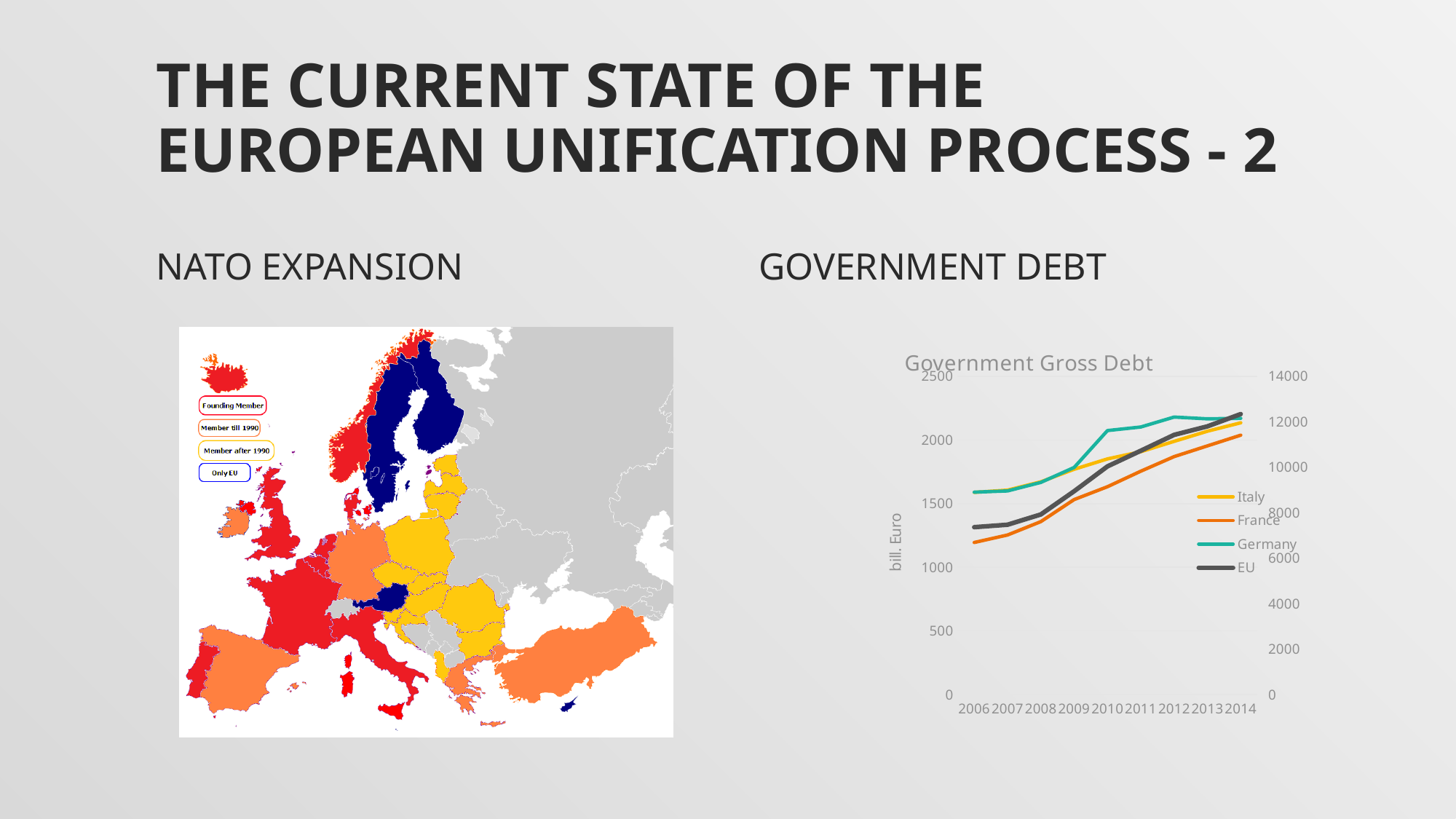
How many years are shown on the x axis of the Government Gross Debt chart? 9 In the Government Gross Debt chart, is the value for Italy in 2006 greater or less than 1500? greater In the Government Gross Debt chart, which is higher in 2006, Italy or France? Italy What is the title of the line chart on the slide? Government Gross Debt In the Government Gross Debt chart, is the value for Germany in 2012 greater or less than 2000? greater In the Government Gross Debt chart, is the value for France in 2006 greater or less than 1500? less What is the label of the left vertical axis of the Government Gross Debt chart? bill. Euro In the Government Gross Debt chart, which is higher in 2012, Germany or France? Germany How many series does the legend of the Government Gross Debt chart list? 4 What kind of chart is the Government Gross Debt chart? line chart In the Government Gross Debt chart, does the France line rise or fall from 2006 to 2014? rise